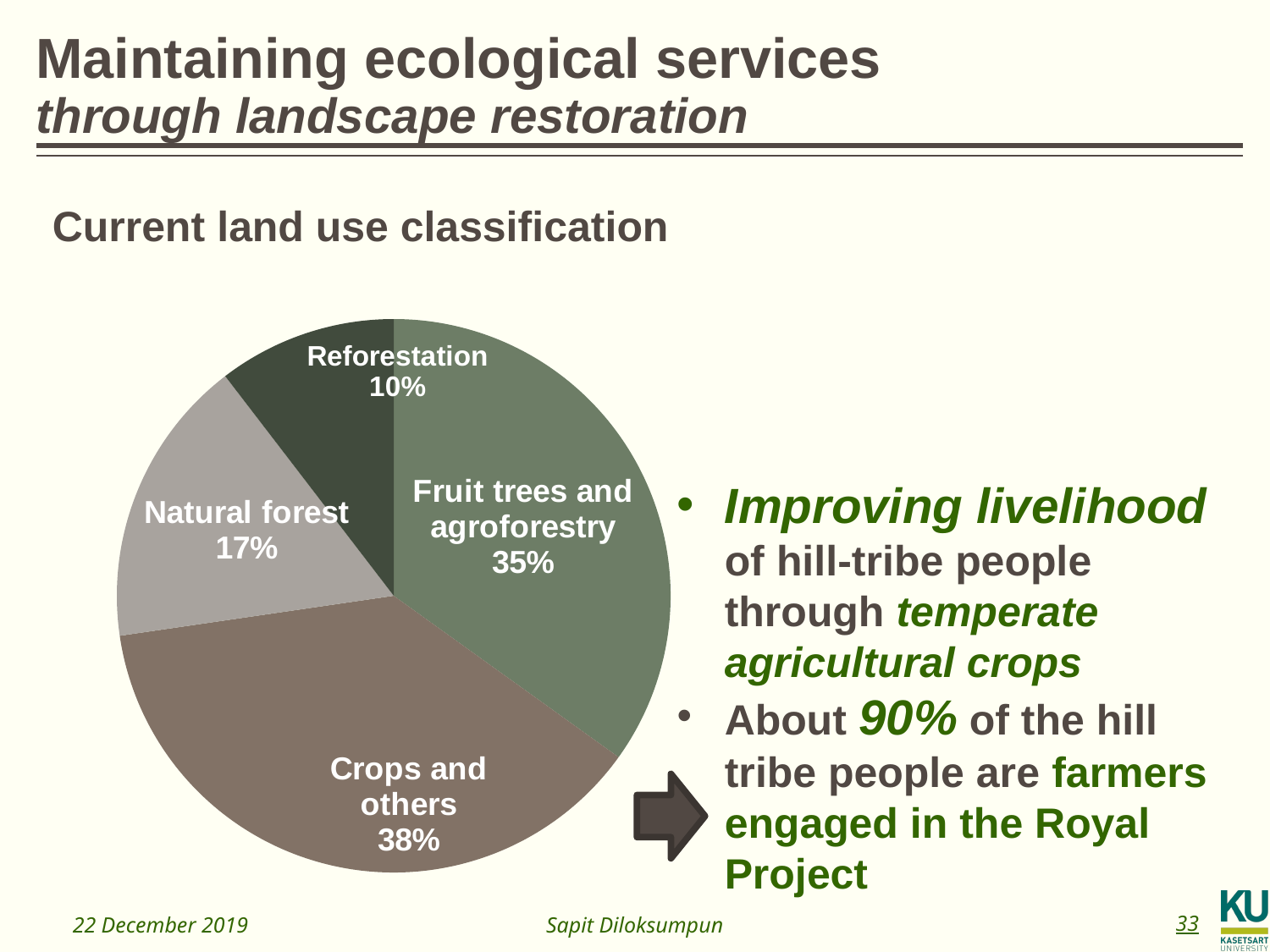
What is the value for Fruit trees and agroforestry? 35% Which category has the smallest share of the pie? Reforestation What is the difference between the shares of Natural forest and Reforestation? 7% What is the difference between the shares of Crops and others and Fruit trees and agroforestry? 3% How many categories are shown in the pie chart? 4 Which category has the largest share of the pie? Crops and others What share of the pie does Crops and others represent? 38% What kind of chart is shown on the slide? Pie chart What is the heading above the pie chart? Current land use classification Which is larger, the share for Natural forest or the share for Reforestation? Natural forest What is the value for Reforestation? 10% What is the value for Natural forest? 17%